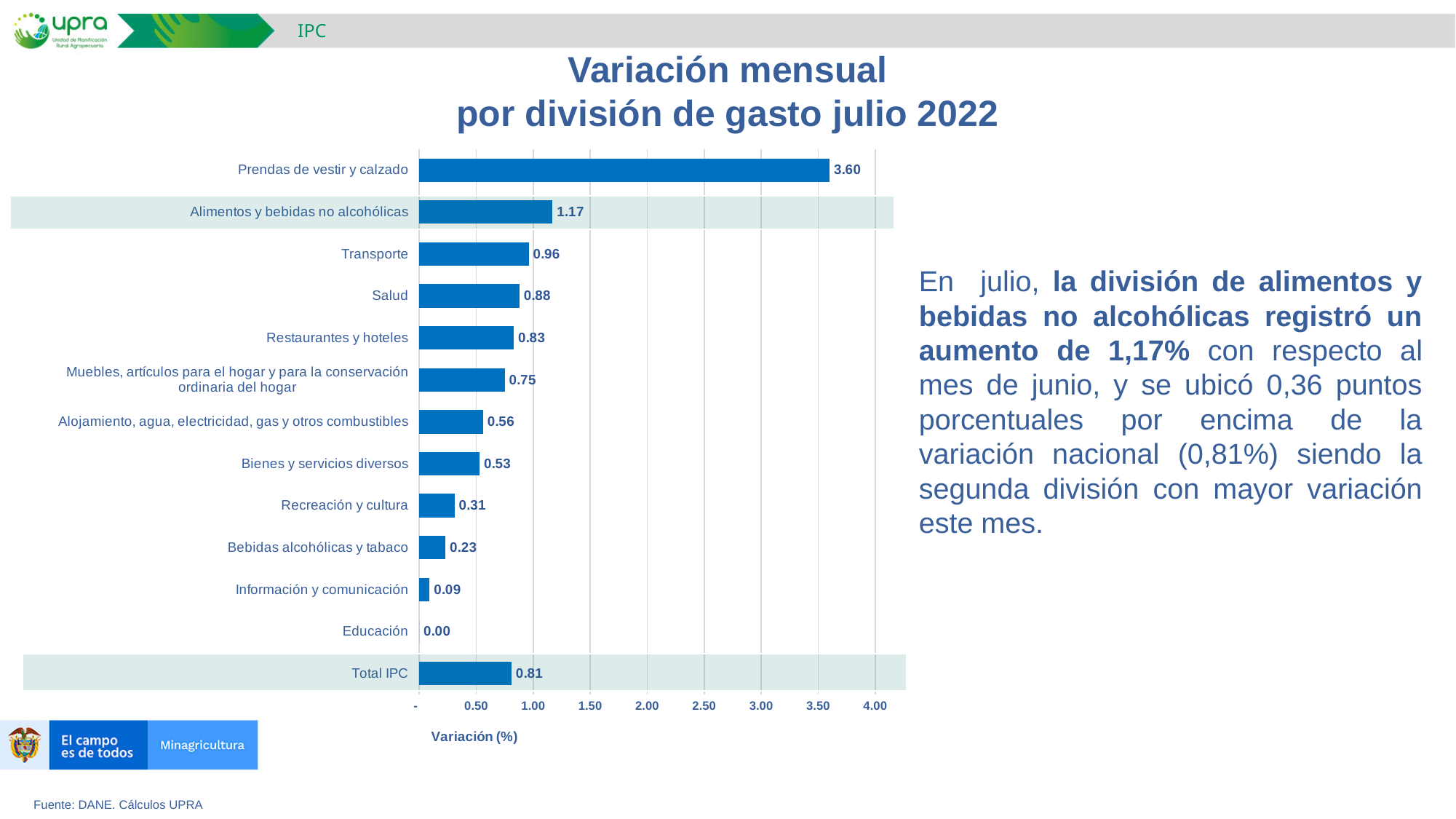
What is the value for Alimentos y bebidas no alcohólicas? 1.17 What is the value for Prendas de vestir y calzado? 3.60 Which is larger, Transporte or Salud? Transporte Is the value for Prendas de vestir y calzado greater or less than 3.00? greater What is the value for Información y comunicación? 0.09 What is the label of the horizontal axis? Variación (%) What kind of chart is this? Bar chart How many categories are shown on the chart? 13 What is the difference between Alimentos y bebidas no alcohólicas and Total IPC? 0.36 Which category has the lowest value? Educación What is the value for Total IPC? 0.81 Which category has the highest value? Prendas de vestir y calzado